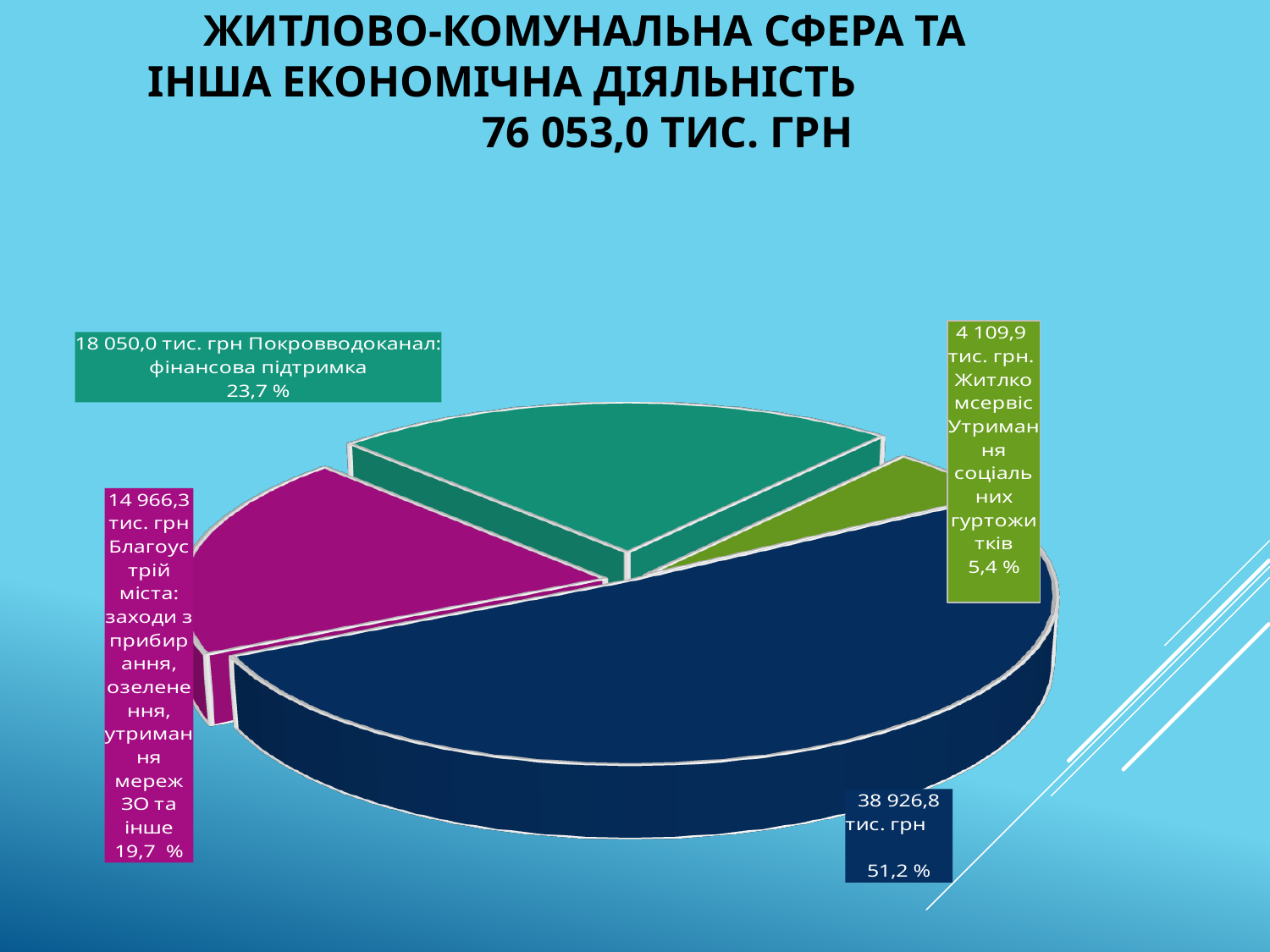
What value is shown for the slice Житлкомсервіс Утримання соціальних гуртожитків? 4 109,9 тис. грн. Which slice has the smallest value? Житлкомсервіс Утримання соціальних гуртожитків Which is larger: the slice for Покроввводоканал: фінансова підтримка or the slice for Благоустрій міста? Покроввводоканал: фінансова підтримка What total amount is stated in the slide title for the whole chart? 76 053,0 тис. грн What share of the pie does the largest (dark blue) slice represent? 51,2 % What share of the pie does the slice Покроввводоканал: фінансова підтримка represent? 23,7 % What is the value of the largest slice of the pie? 38 926,8 тис. грн What value is shown for the slice Благоустрій міста? 14 966,3 тис. грн What share of the pie does the slice Житлкомсервіс Утримання соціальних гуртожитків represent? 5,4 % How many slices does the pie chart have? 4 What value is shown for the slice labelled Покроввводоканал: фінансова підтримка? 18 050,0 тис. грн What kind of chart is shown on the slide? pie chart